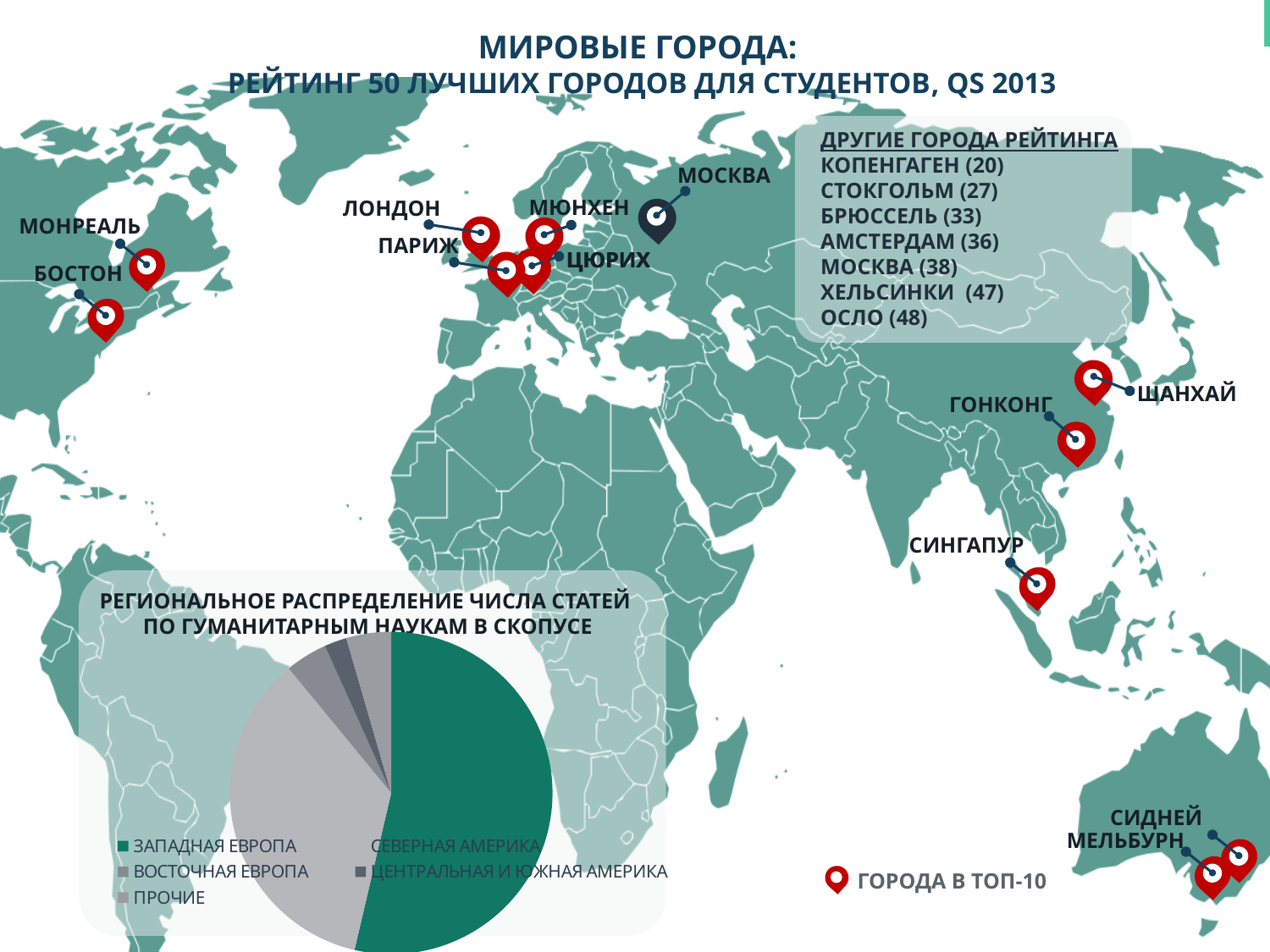
What kind of chart is shown in the lower-left panel of the slide? pie chart What is the title of the pie chart on the slide? Региональное распределение числа статей по гуманитарным наукам в Скопусе Which legend entry of the pie chart is shown in dark green? Западная Европа How many categories does the legend of the pie chart list? 5 Which category has the largest slice in the pie chart? Западная Европа In the pie chart, which slice is larger: Западная Европа or Восточная Европа? Западная Европа